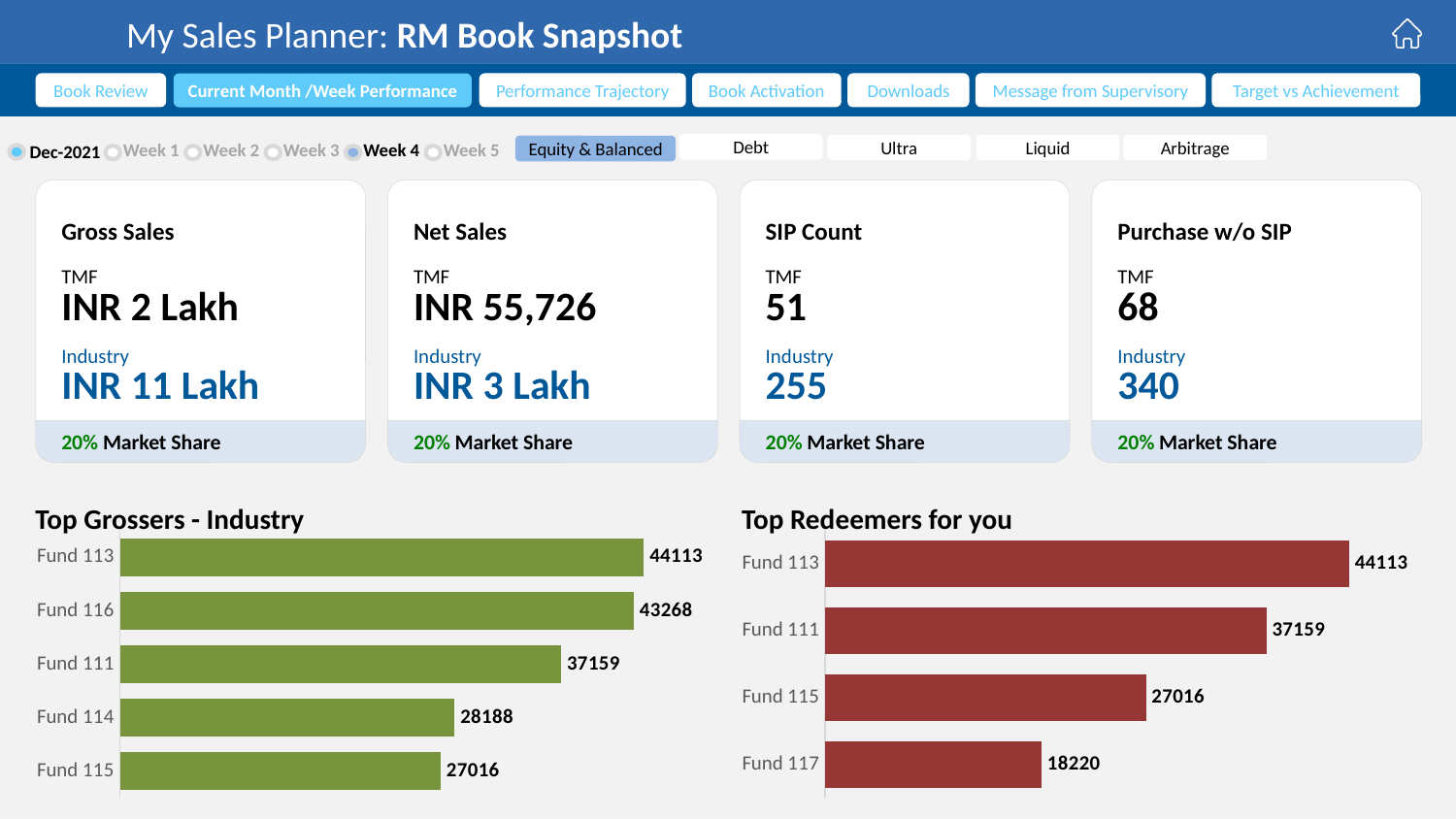
How many funds are shown in the 'Top Grossers - Industry' chart? 5 In the 'Top Grossers - Industry' chart, which fund has the lowest value? Fund 115 In the 'Top Redeemers for you' chart, which is larger, the value for Fund 111 or the value for Fund 117? Fund 111 In the 'Top Grossers - Industry' chart, what is the value for Fund 116? 43268 In the 'Top Redeemers for you' chart, what is the difference between the values for Fund 111 and Fund 115? 10143 In the 'Top Grossers - Industry' chart, what is the difference between the values for Fund 113 and Fund 116? 845 In the 'Top Redeemers for you' chart, what is the value for Fund 117? 18220 In the 'Top Grossers - Industry' chart, what is the value for Fund 114? 28188 In the 'Top Grossers - Industry' chart, which fund has the highest value? Fund 113 In the 'Top Redeemers for you' chart, which fund has the lowest value? Fund 117 What kind of chart is the 'Top Redeemers for you' chart? Bar chart In the 'Top Redeemers for you' chart, what is the value for Fund 115? 27016